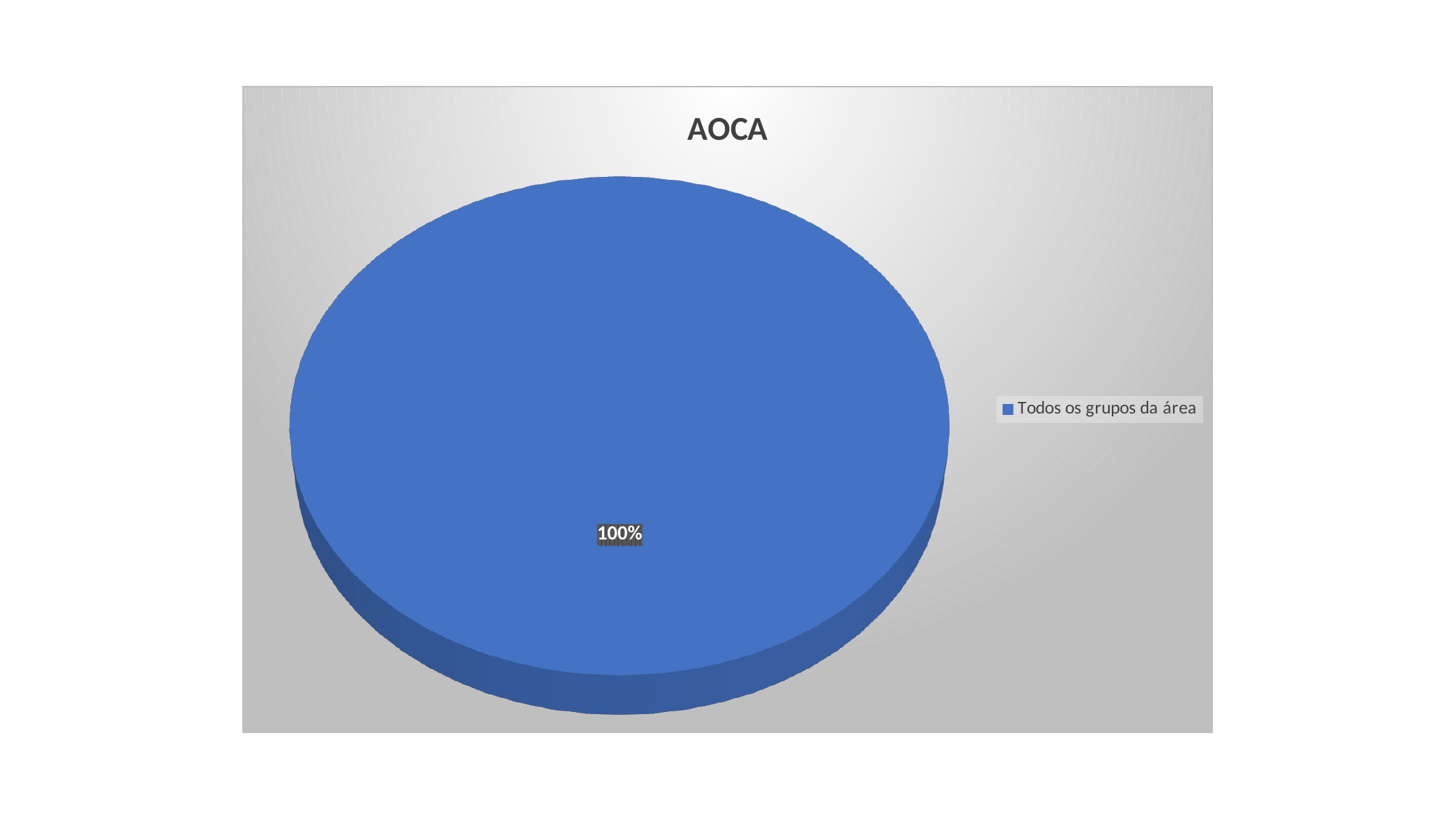
Is the share for "Todos os grupos da área" greater or less than 50%? greater How many slices does the pie chart have? 1 What kind of chart is shown on the slide? pie chart What is the data label shown on the pie slice? 100% What share of the pie does "Todos os grupos da área" represent? 100% What is the legend entry for the blue slice? Todos os grupos da área How many entries does the legend list? 1 What is the title of the chart? AOCA